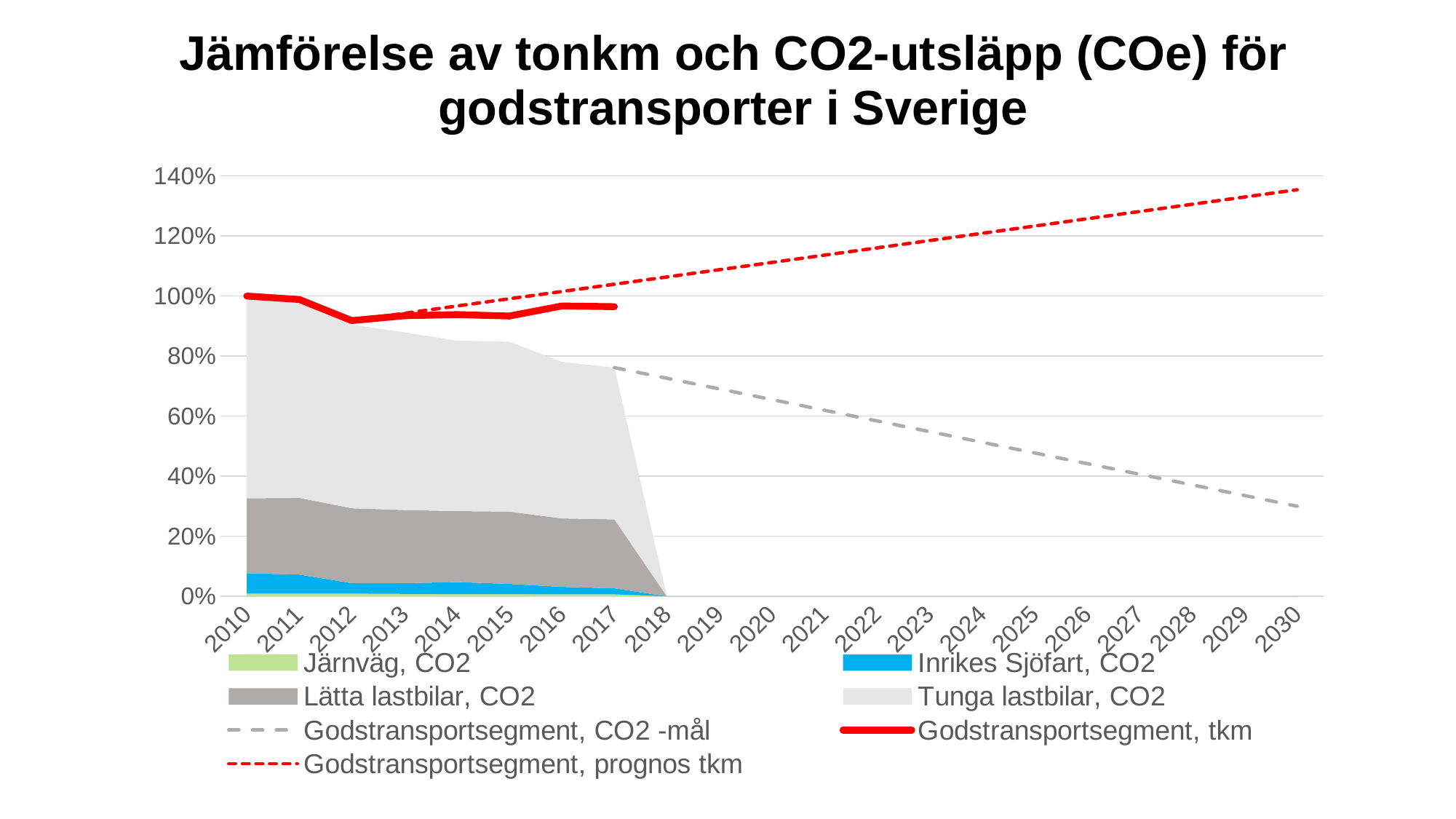
Is the value of Godstransportsegment, prognos tkm in 2030 greater or less than 120%? greater How many series does the legend list? 7 Is the value of Godstransportsegment, CO2 -mål in 2024 greater or less than 80%? less Is the value of Godstransportsegment, tkm in 2012 greater or less than 100%? less Does the Godstransportsegment, CO2 -mål line rise or fall from 2018 to 2030? fall What kind of chart is this? Stacked area chart with line series Does the Godstransportsegment, prognos tkm line rise or fall from 2013 to 2030? rise In 2030, which is higher: Godstransportsegment, prognos tkm or Godstransportsegment, CO2 -mål? Godstransportsegment, prognos tkm What is the title of the chart? Jämförelse av tonkm och CO2-utsläpp (COe) för godstransporter i Sverige Which series is drawn as a solid red line? Godstransportsegment, tkm How many years are shown on the x axis? 21